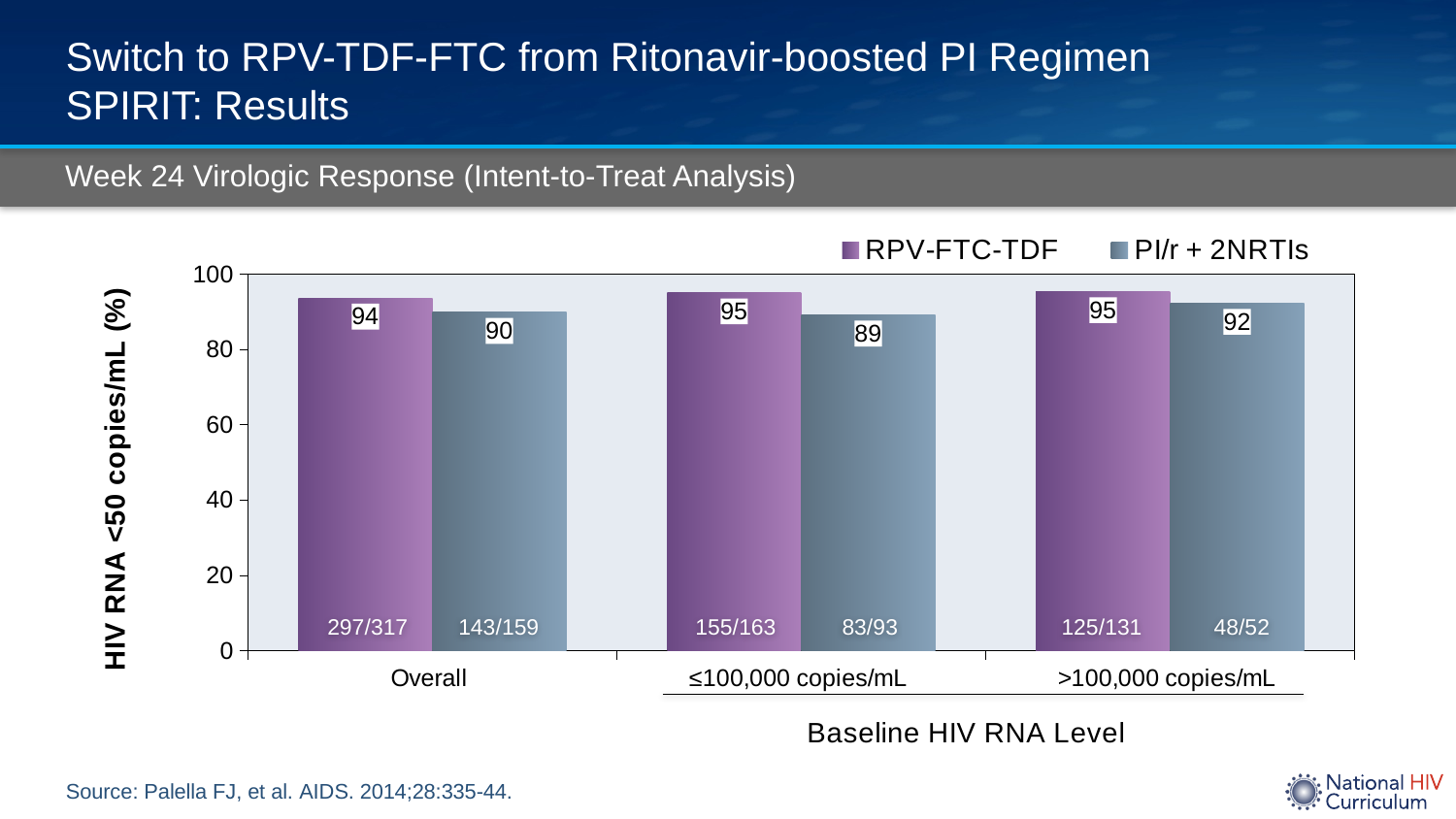
What is the difference between the RPV-FTC-TDF and PI/r + 2NRTIs values in the ≤100,000 copies/mL category? 6 How many series does the legend list? 2 Which is larger in the >100,000 copies/mL category: RPV-FTC-TDF or PI/r + 2NRTIs? RPV-FTC-TDF What is the value for PI/r + 2NRTIs in the ≤100,000 copies/mL category? 89 What is the value for PI/r + 2NRTIs in the >100,000 copies/mL category? 92 What is the difference between the RPV-FTC-TDF and PI/r + 2NRTIs values in the Overall category? 4 What is the value for RPV-FTC-TDF in the Overall category? 94 How many categories are shown on the x axis? 3 What is the y-axis label of the chart? HIV RNA <50 copies/mL (%) Which category has the lowest value for PI/r + 2NRTIs? ≤100,000 copies/mL What is the value for RPV-FTC-TDF in the >100,000 copies/mL category? 95 What kind of chart is shown on the slide? Bar chart